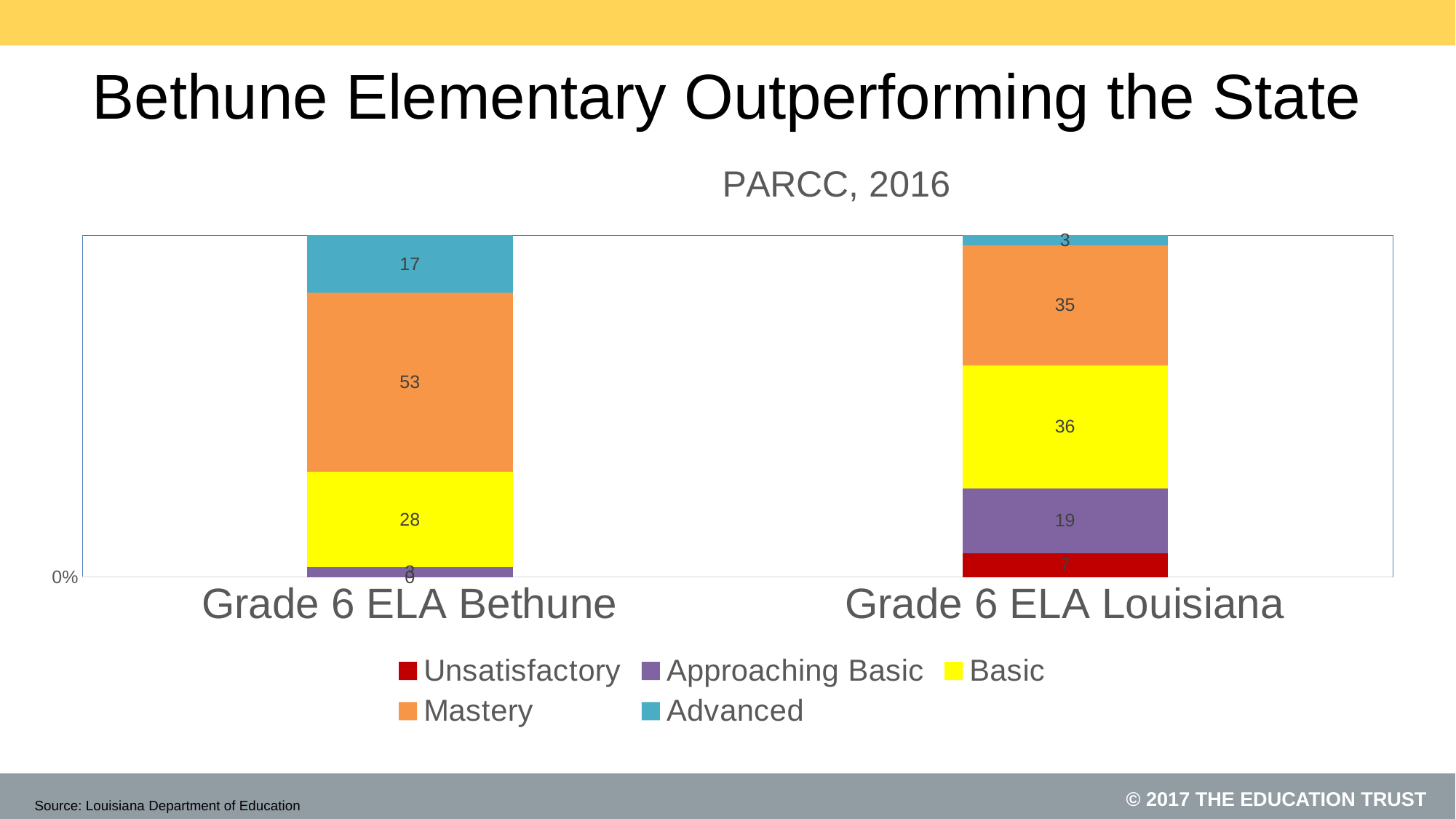
What is the difference between the Mastery values for Grade 6 ELA Bethune and Grade 6 ELA Louisiana? 18 What is the Basic value for Grade 6 ELA Louisiana? 36 What is the Advanced value for Grade 6 ELA Louisiana? 3 What kind of chart is shown on the slide? Stacked bar chart What is the title of the chart? PARCC, 2016 How many series does the legend list? 5 Which performance level has the largest value in the Grade 6 ELA Bethune bar? Mastery Which has the larger Advanced value, Grade 6 ELA Bethune or Grade 6 ELA Louisiana? Grade 6 ELA Bethune What is the Approaching Basic value for Grade 6 ELA Louisiana? 19 What is the Unsatisfactory value for Grade 6 ELA Louisiana? 7 How many bars are shown in the chart? 2 What is the Mastery value for Grade 6 ELA Bethune? 53